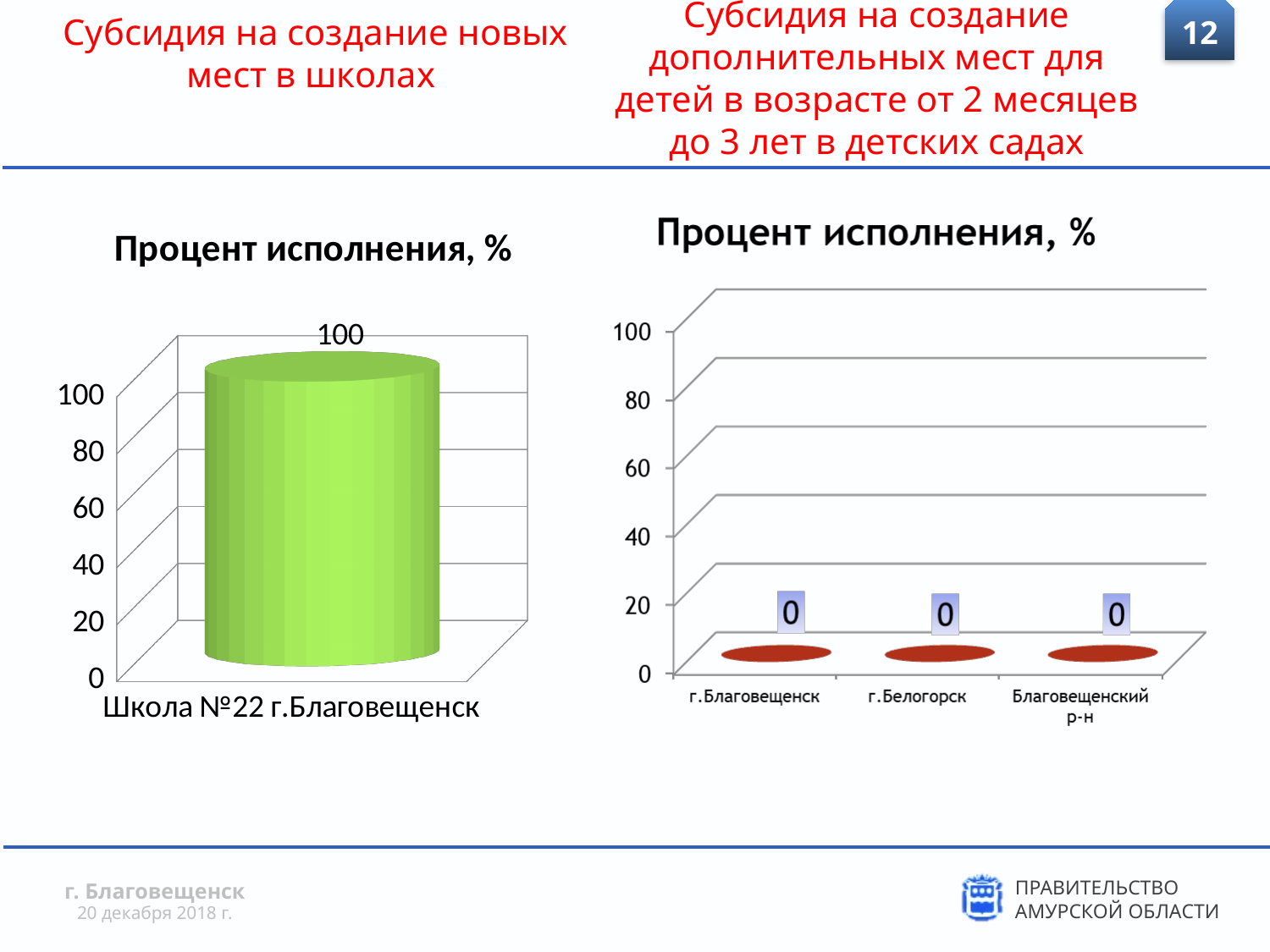
On the right chart, what is the value for Благовещенский р-н? 0 On the right chart, what is the value for г.Белогорск? 0 What is the highest value shown on the left chart's vertical axis? 100 What kind of chart is the right chart? bar chart What kind of chart is the left chart? bar chart How many categories are shown on the right chart? 3 On the right chart, what is the value for г.Благовещенск? 0 What is the difference between the value for Школа №22 г.Благовещенск on the left chart and the value for г.Благовещенск on the right chart? 100 On the left chart, what is the value for Школа №22 г.Благовещенск? 100 What is the title of the left chart? Процент исполнения, % Which is larger: the value for Школа №22 г.Благовещенск on the left chart or the value for г.Белогорск on the right chart? Школа №22 г.Благовещенск How many categories are shown on the left chart? 1